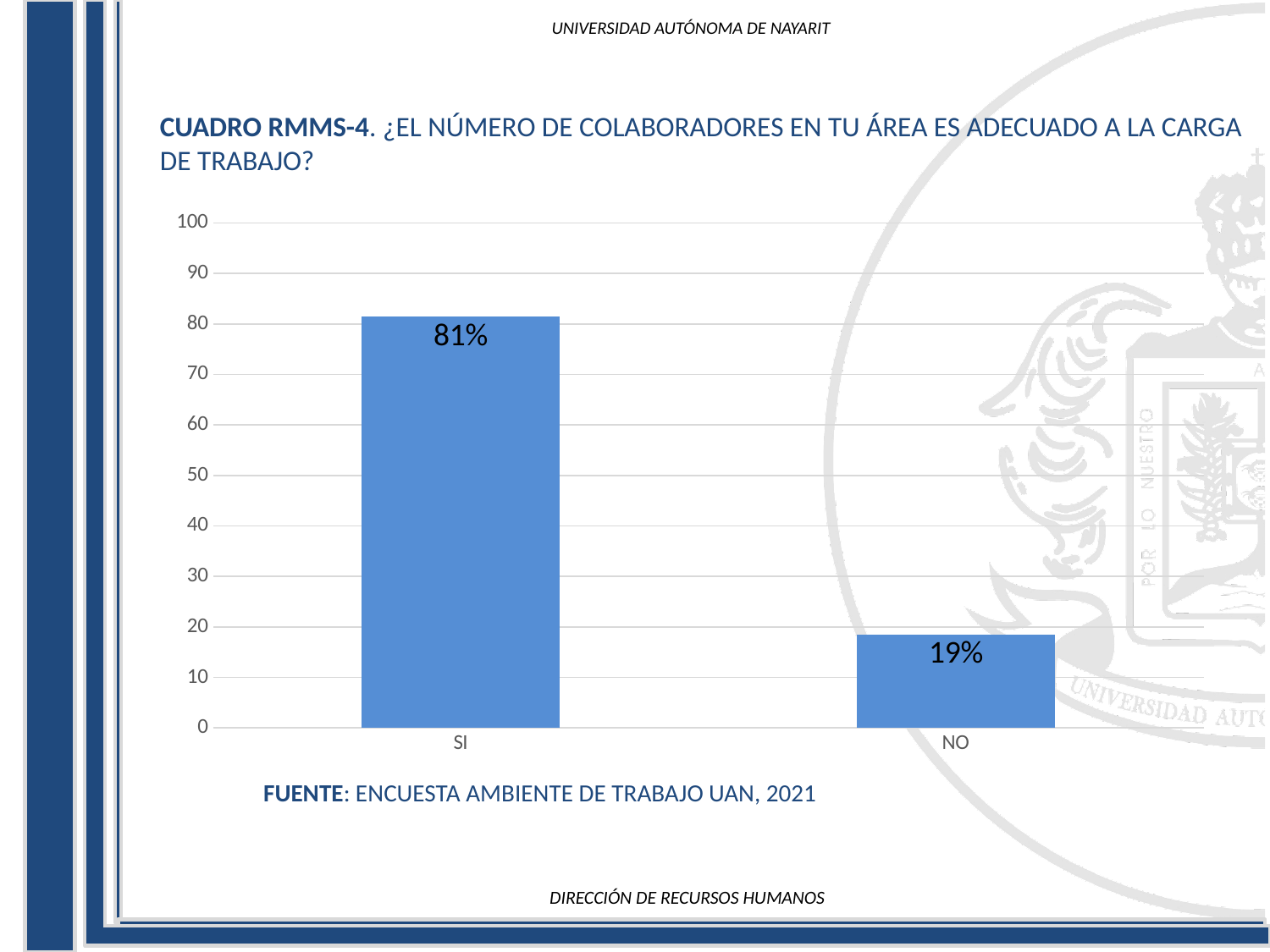
What is the highest value shown on the vertical axis? 100 What is the value for SI? 81% Is the value for SI greater or less than 80? greater What is the difference between the values for SI and NO? 62% Which is larger, the value for SI or the value for NO? SI What source is cited below the chart? ENCUESTA AMBIENTE DE TRABAJO UAN, 2021 Which category has the lowest value? NO Which category has the highest value? SI What is the value for NO? 19% How many categories are shown on the x axis? 2 Is the value for NO greater or less than 20? less What kind of chart is shown on the slide? bar chart